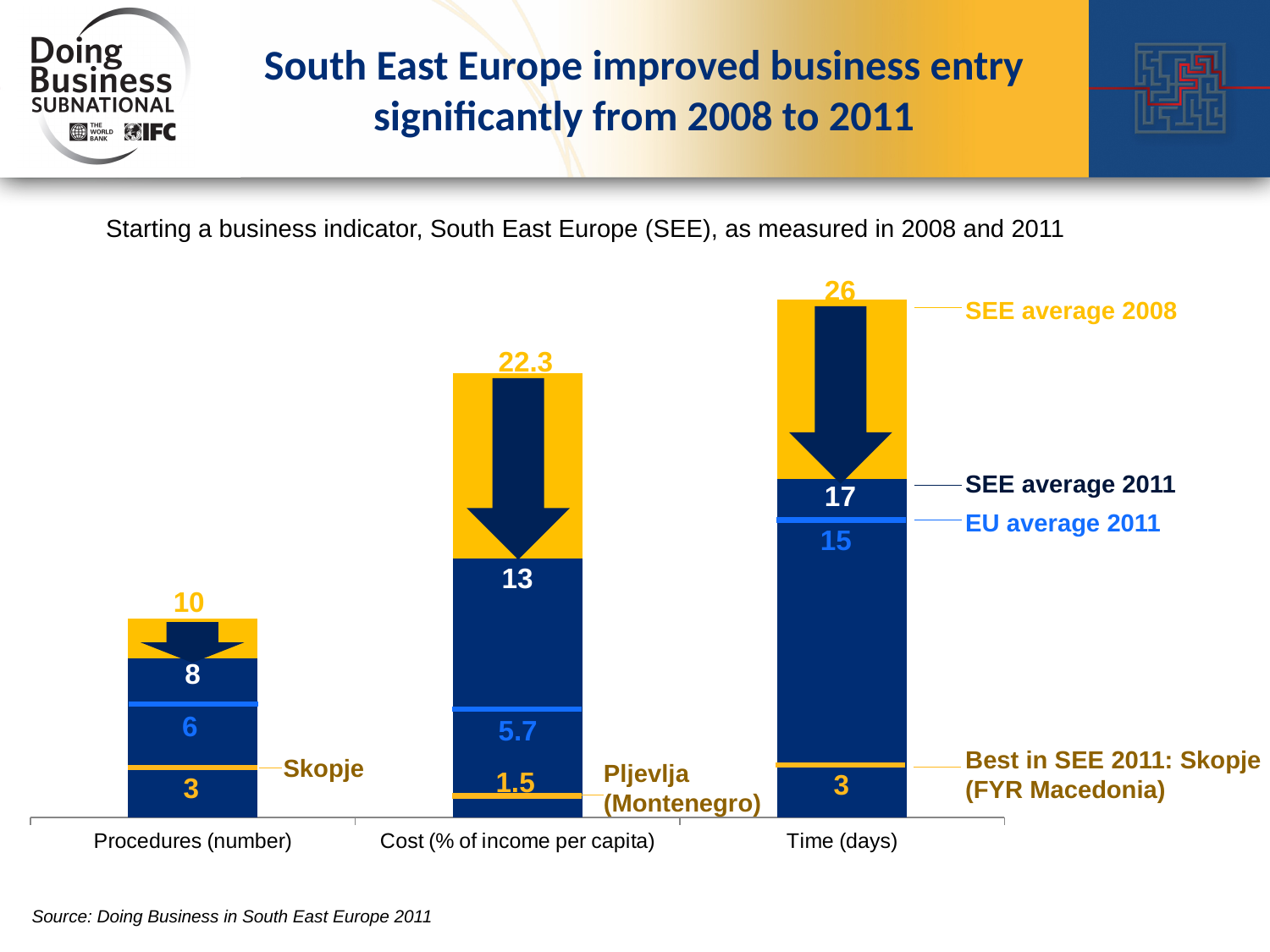
How many categories are shown on the x axis of the chart? 3 Which city is labelled as Best in SEE 2011 for Cost (% of income per capita)? Pljevlja (Montenegro) Which is larger for Time (days): the SEE average 2011 or the EU average 2011? SEE average 2011 What was the EU average 2011 value for Procedures (number)? 6 Which category has the highest SEE average 2008 value? Time (days) By how much did the SEE average for Time (days) fall from 2008 to 2011? 9 What was the SEE average 2011 value for Cost (% of income per capita)? 13 What kind of chart is shown on the slide? Bar chart What is the difference between the SEE average 2011 and the EU average 2011 for Procedures (number)? 2 What was the SEE average 2008 value for Time (days)? 26 What was the SEE average 2008 value for Cost (% of income per capita)? 22.3 What is the Best in SEE 2011 value for Cost (% of income per capita)? 1.5